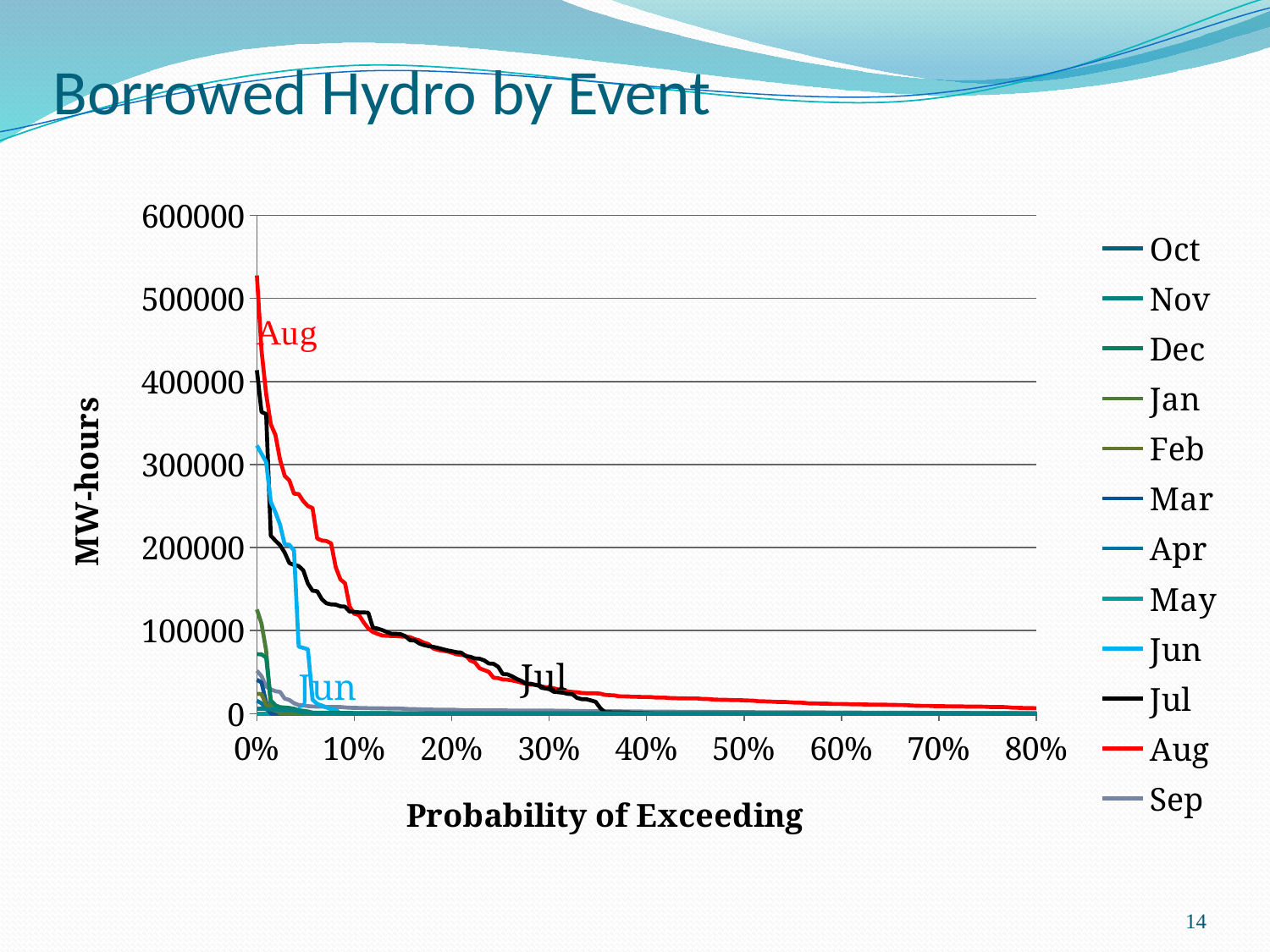
Is the maximum value of the Jul series greater or less than 500000? less Is the maximum value of the Aug series greater or less than 500000? greater What is the title of the chart? Borrowed Hydro by Event Is the maximum value of the Jun series greater or less than 300000? greater Which series reaches the highest value on the chart? Aug Do the values of the Aug series rise or fall as the probability of exceeding increases? fall Which series has a higher peak value, Jul or Jun? Jul What kind of chart is shown on the slide? line chart Which series extends furthest along the x axis before reaching zero, Jul or Aug? Aug How many series does the legend list? 12 What is the label on the vertical axis? MW-hours